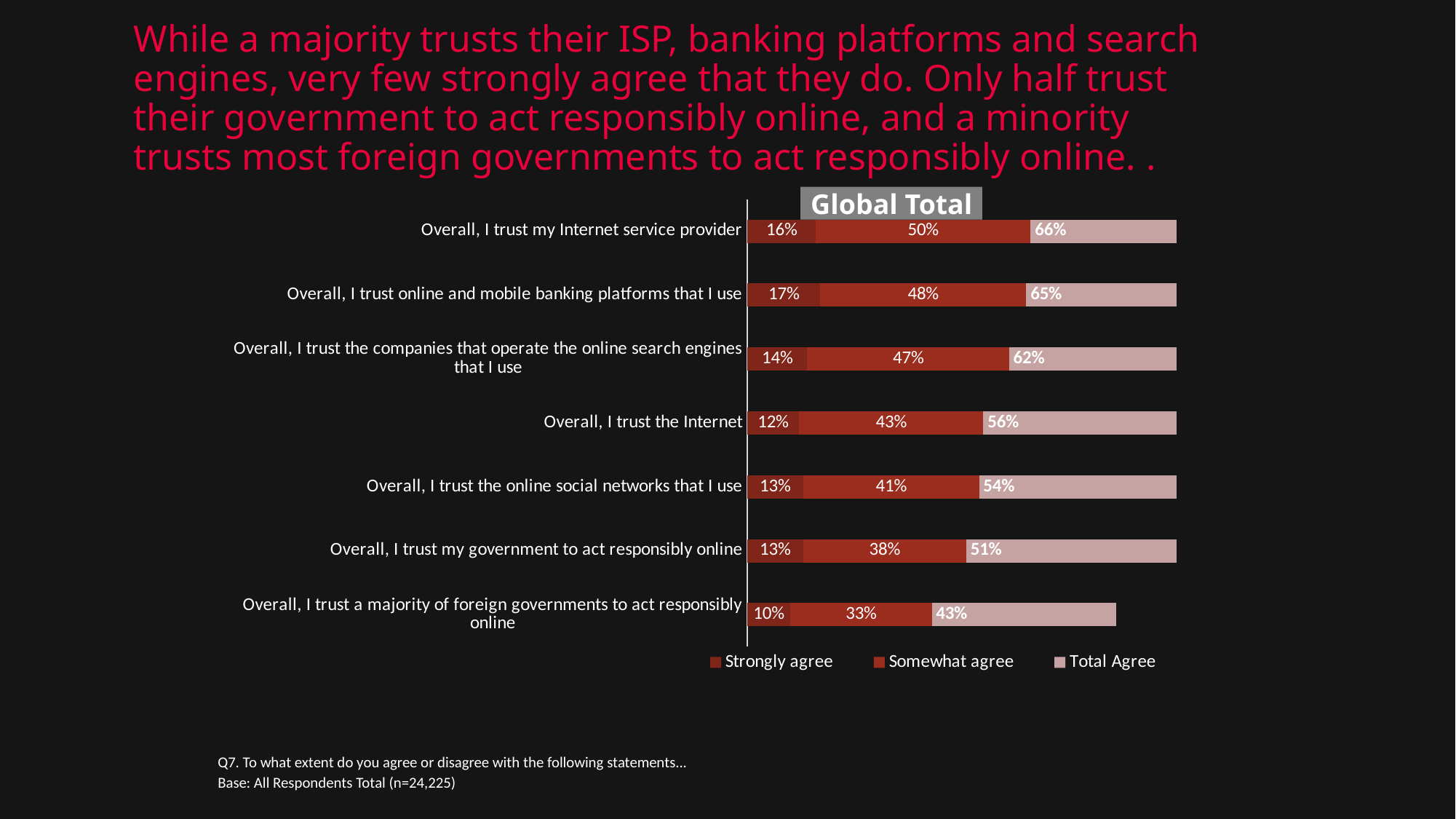
Which has a higher Somewhat agree value: "Overall, I trust online and mobile banking platforms that I use" or "Overall, I trust the online social networks that I use"? Overall, I trust online and mobile banking platforms that I use What is the Total Agree value for "Overall, I trust my government to act responsibly online"? 51% What is the Somewhat agree value for "Overall, I trust the Internet"? 43% How many statements are shown in the chart? 7 What is the difference between the Total Agree values for "Overall, I trust my Internet service provider" and "Overall, I trust a majority of foreign governments to act responsibly online"? 23% What is the Strongly agree value for "Overall, I trust the companies that operate the online search engines that I use"? 14% How many series does the legend list? 3 Which statement has the highest Total Agree value? Overall, I trust my Internet service provider What kind of chart is shown on the slide? Bar chart What is the title shown above the chart? Global Total Which statement has the lowest Strongly agree value? Overall, I trust a majority of foreign governments to act responsibly online What is the Strongly agree value for "Overall, I trust my Internet service provider"? 16%